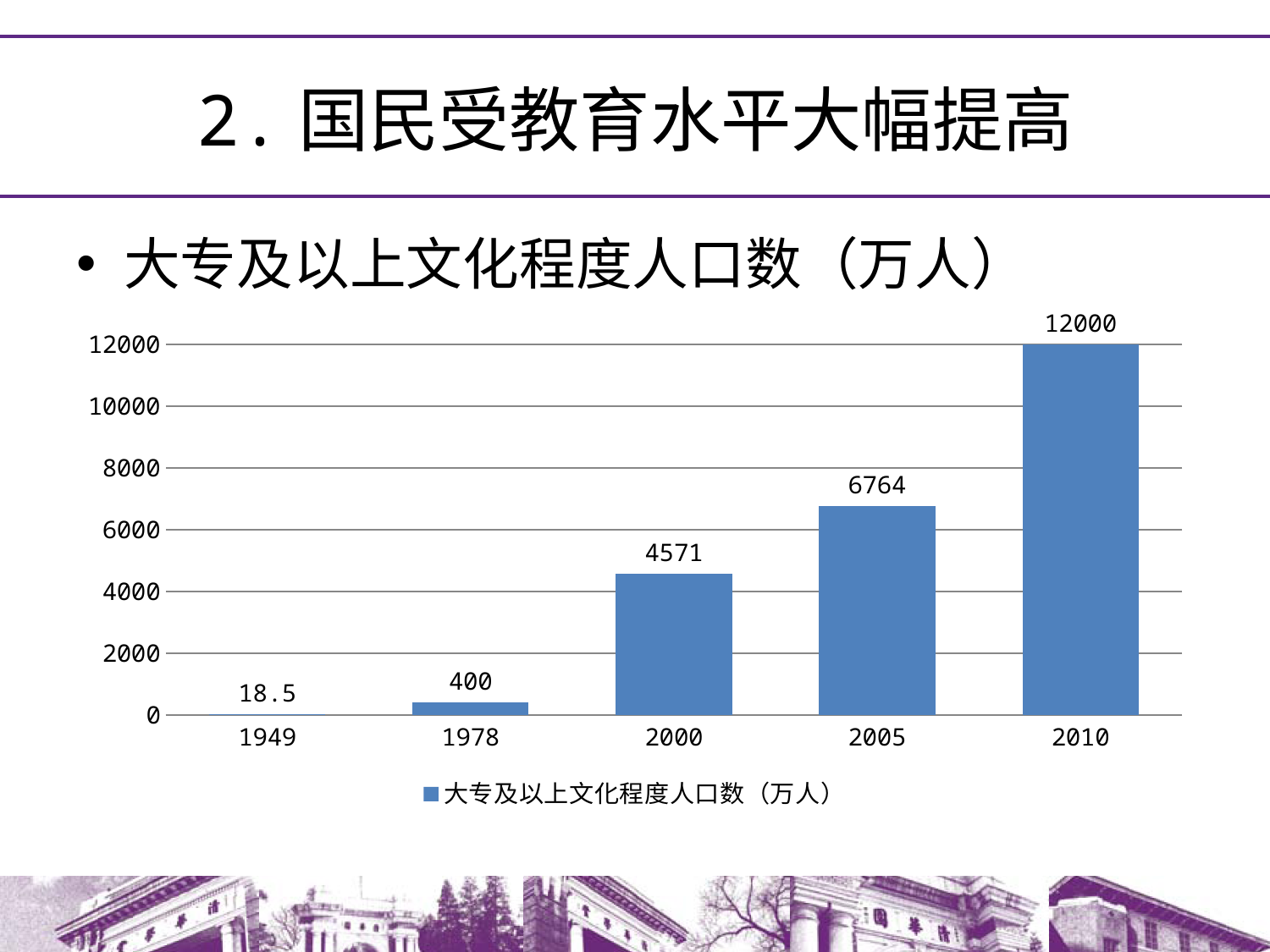
Which year has the highest value? 2010 What is the difference between the values for 2000 and 1978? 4171 How many series does the legend list? 1 What kind of chart is shown? bar chart What is the value for 2000? 4571 How many years are shown on the x axis? 5 What is the value for 2005? 6764 Which year has the lowest value? 1949 What is the difference between the values for 2010 and 2005? 5236 What is the value for 1949? 18.5 Which is larger, the value for 1978 or the value for 2000? 2000 Do the values rise or fall from 1949 to 2010? rise